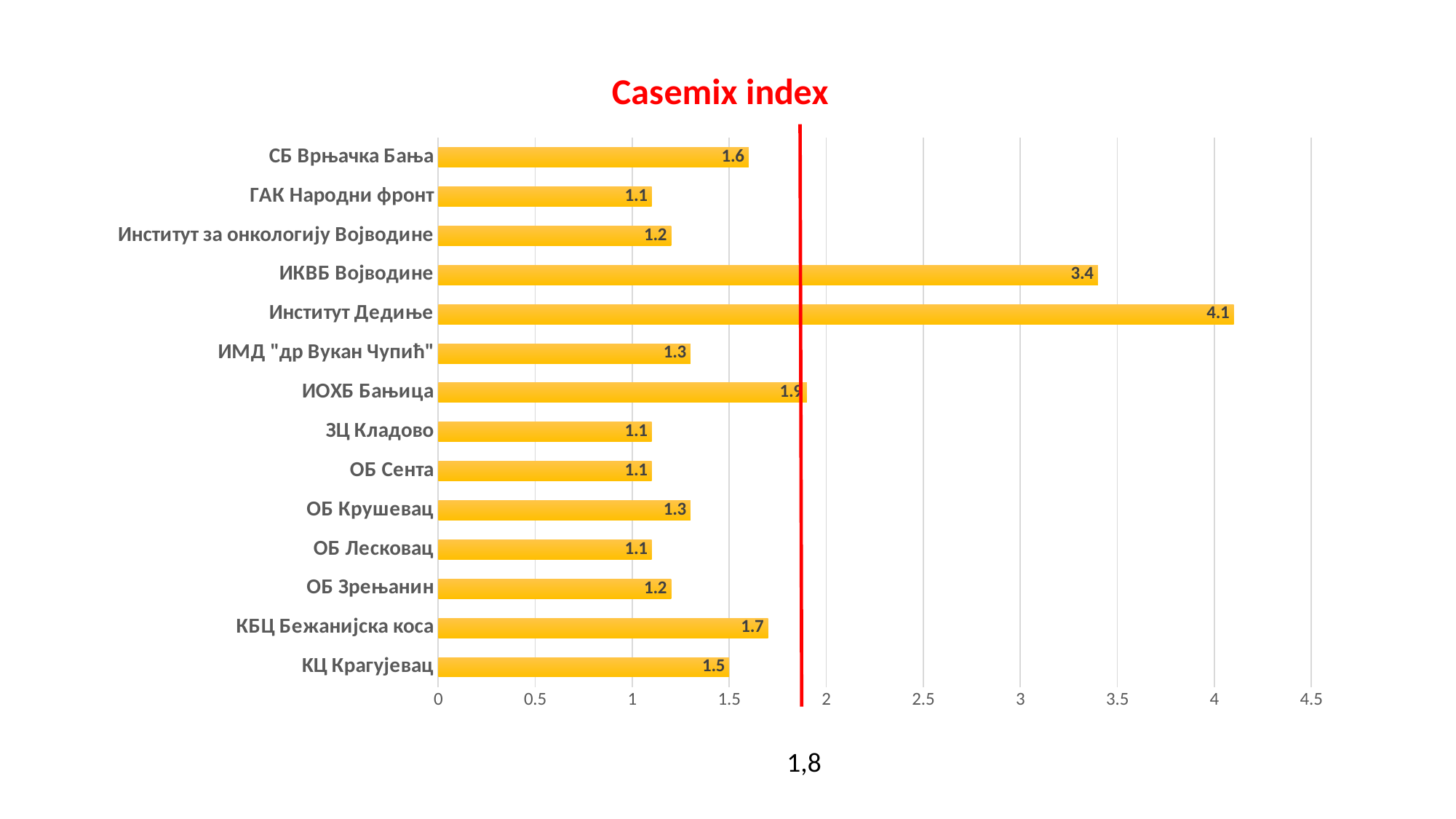
What is the Casemix index value for ИОХБ Бањица? 1.9 How many categories are shown in the chart? 14 Is the value for ИКВБ Војводине greater or less than 3? greater What is the Casemix index value for ИКВБ Војводине? 3.4 Which category has the highest Casemix index? Институт Дедиње What value is marked by the red vertical line on the chart? 1,8 Which has a larger Casemix index, СБ Врњачка Бања or КЦ Крагујевац? СБ Врњачка Бања What is the title of the chart? Casemix index What kind of chart is shown on the slide? Bar chart What is the Casemix index value for Институт Дедиње? 4.1 What is the Casemix index value for КБЦ Бежанијска коса? 1.7 What is the difference between the Casemix index of Институт Дедиње and ИКВБ Војводине? 0.7